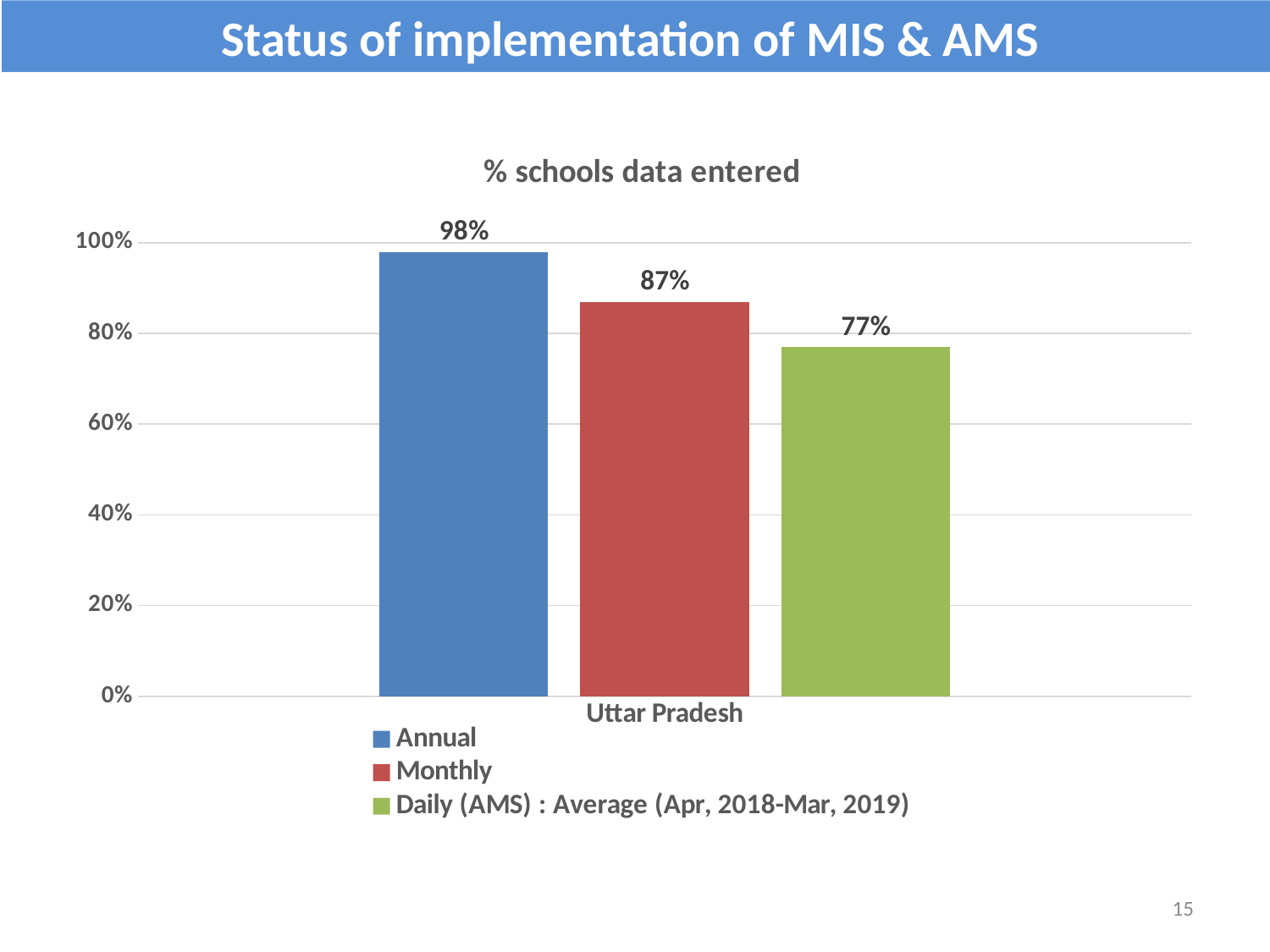
What is the value for Monthly in the chart? 87% What is the value for Annual in the chart? 98% Which series has the lowest value? Daily (AMS) : Average (Apr, 2018-Mar, 2019) What is the difference between the Annual and Monthly values? 11% Which series has the highest value? Annual What is the title of the chart? % schools data entered Is the value for Daily (AMS) greater or less than 80%? less How many series does the legend list? 3 Which is larger, the Monthly value or the Daily (AMS) value? Monthly What is the value for Daily (AMS) : Average (Apr, 2018-Mar, 2019) in the chart? 77% What is the difference between the Monthly and Daily (AMS) values? 10% What kind of chart is shown on the slide? bar chart